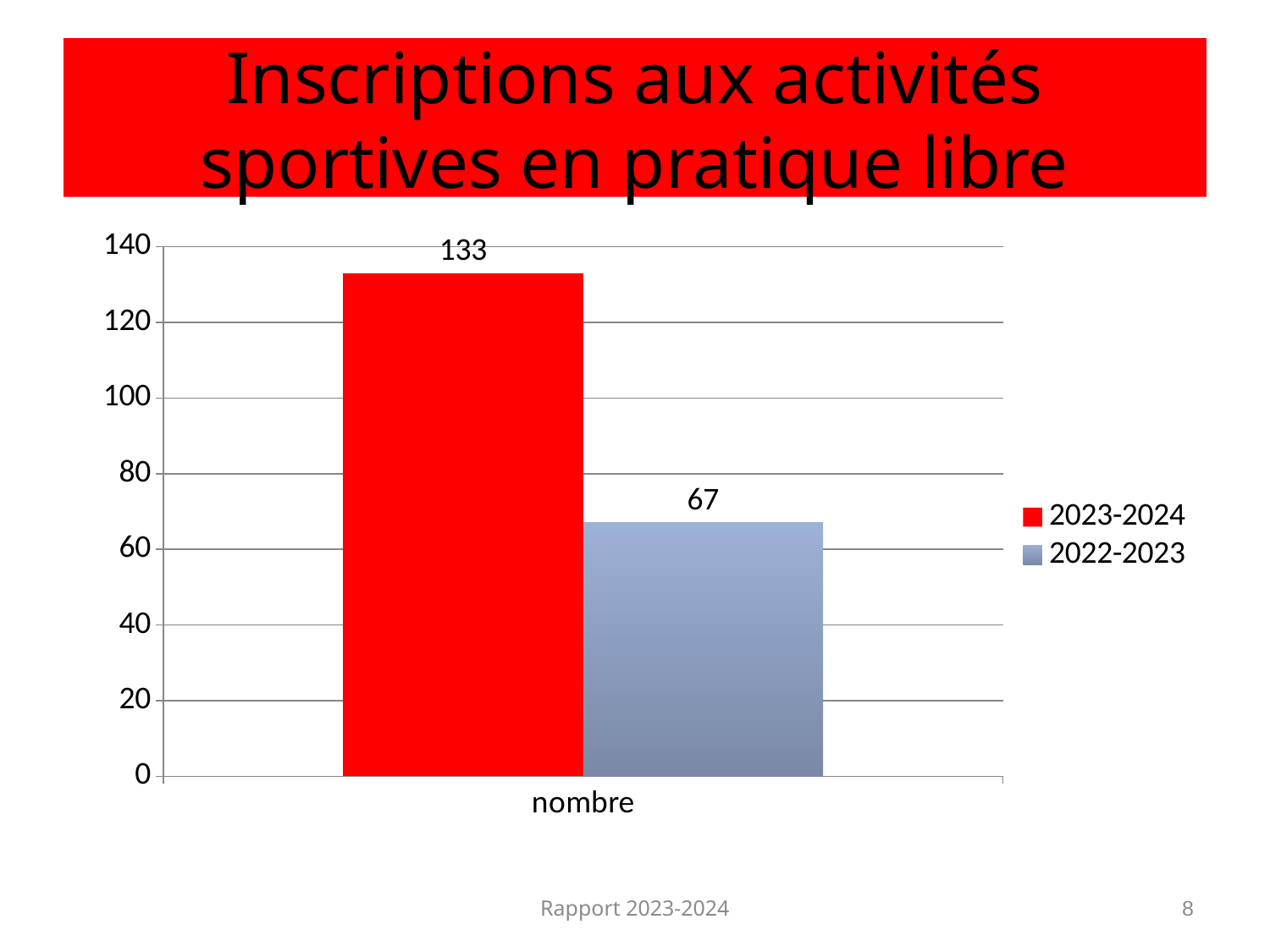
Which series has the higher value, 2023-2024 or 2022-2023? 2023-2024 Is the value for 2023-2024 larger or smaller than the value for 2022-2023? larger What is the value for 2023-2024? 133 Is the value for 2023-2024 greater or less than 120? greater What kind of chart is shown on the slide? bar chart What is the category label on the x axis? nombre What is the difference between the 2023-2024 value and the 2022-2023 value? 66 What colour is the bar for 2023-2024? red Which series has the lower value? 2022-2023 Is the value for 2022-2023 greater or less than 80? less What is the value for 2022-2023? 67 How many series does the legend list? 2